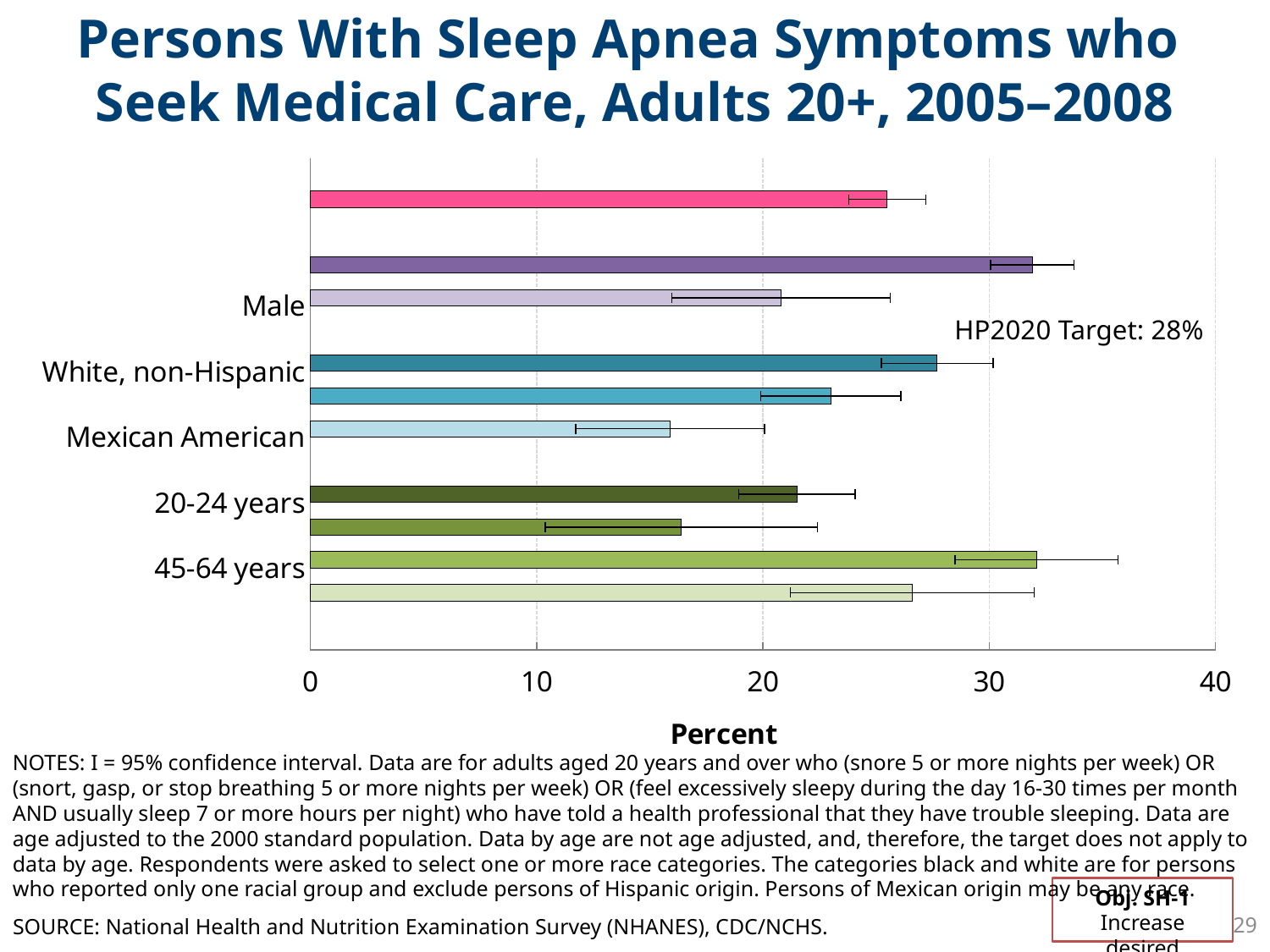
Which is larger, the value for 45-64 years or the value for 20-24 years? 45-64 years Is the value for White, non-Hispanic greater or less than 20? greater What type of chart is shown on the slide? bar chart Is the value for 20-24 years greater or less than 30? less Is the value for Mexican American greater or less than 20? less What is the title of the horizontal axis? Percent Which is larger, the value for White, non-Hispanic or the value for Mexican American? White, non-Hispanic What is the HP2020 target shown on the chart? 28% How many bars are plotted on the chart? 10 Among the labeled categories, which has the lowest value? Mexican American